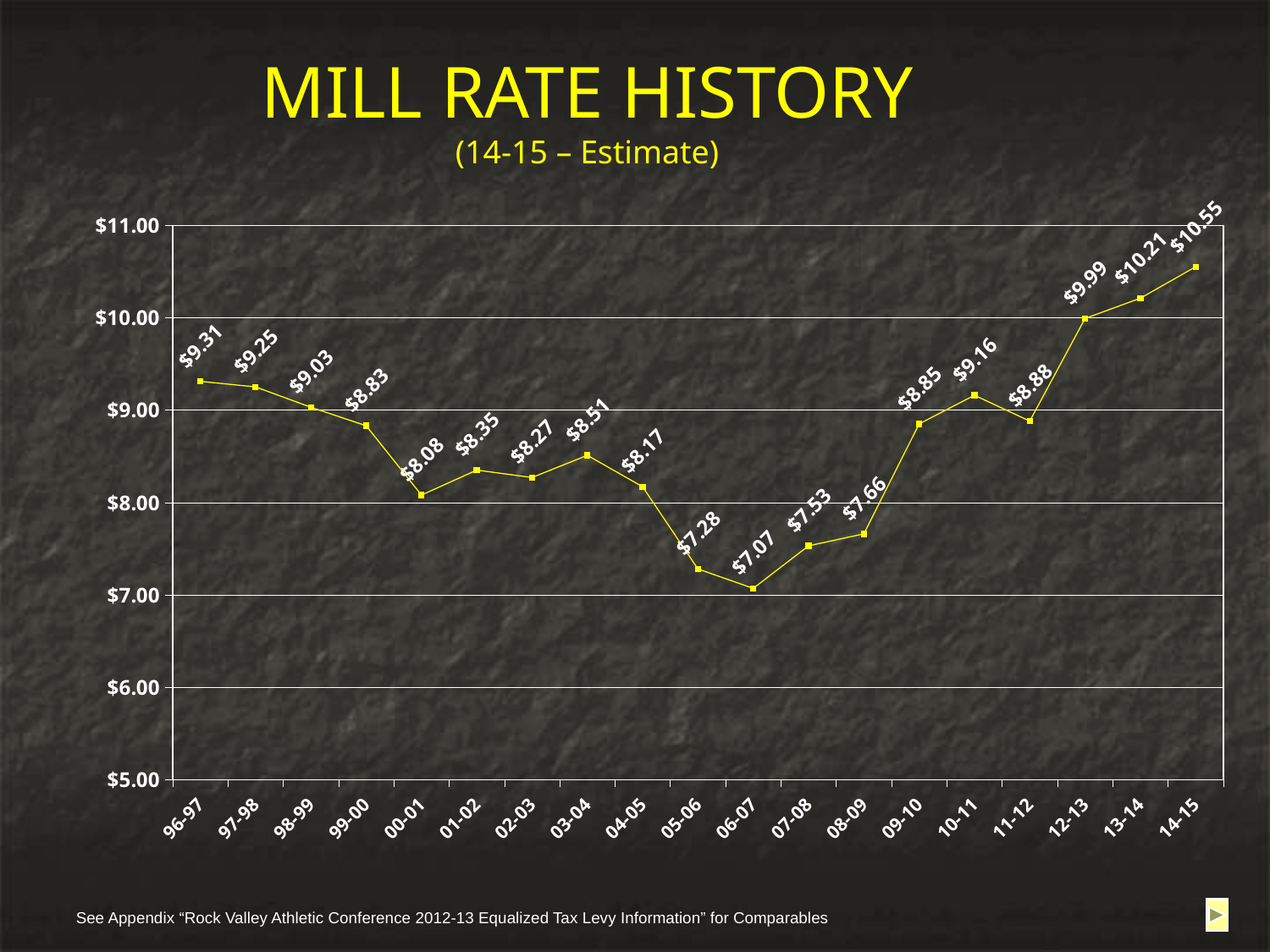
What is the title of the chart? MILL RATE HISTORY What is the mill rate for 09-10? $8.85 What is the mill rate for 96-97? $9.31 What is the difference between the mill rate for 14-15 and the mill rate for 06-07? $3.48 How many years are plotted on the chart? 19 Which year has the lowest mill rate? 06-07 Which is larger, the mill rate for 10-11 or the mill rate for 11-12? 10-11 What is the mill rate for 14-15? $10.55 Which year has the highest mill rate? 14-15 Does the mill rate rise or fall from 11-12 to 14-15? rise What type of chart is shown on the slide? line chart What is the mill rate for 06-07? $7.07